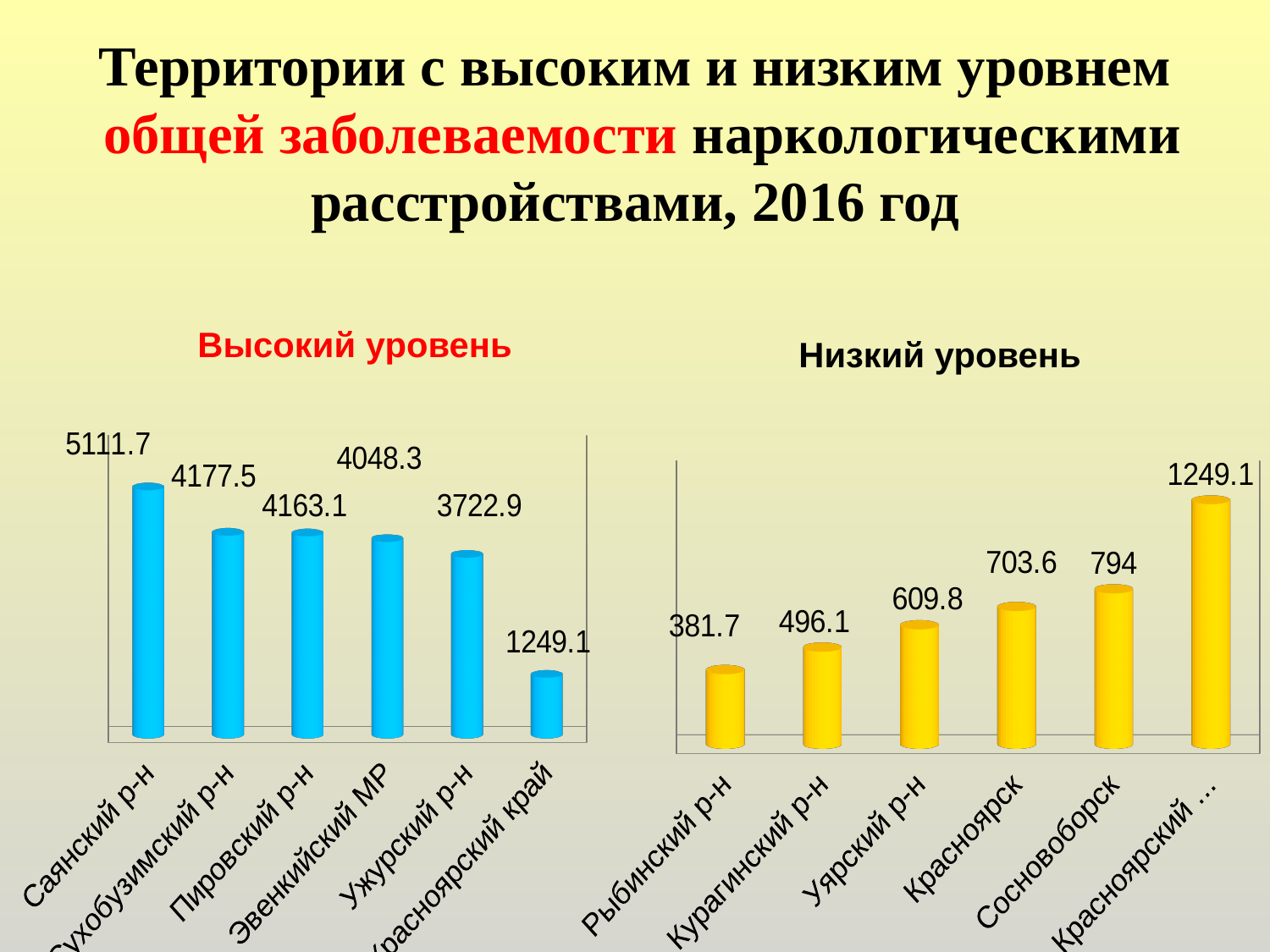
In the 'Низкий уровень' chart, what is the difference between Красноярск and Курагинский р-н? 207.5 In the 'Низкий уровень' chart, which is larger: Уярский р-н or Красноярск? Красноярск In the 'Высокий уровень' chart, which category has the lowest value? Красноярский край In the 'Высокий уровень' chart, how many bars are plotted? 6 In the 'Высокий уровень' chart, what is the difference between Саянский р-н and Ужурский р-н? 1388.8 In the 'Низкий уровень' chart, what is the value for Рыбинский р-н? 381.7 In the 'Высокий уровень' chart, what is the value for Эвенкийский МР? 4048.3 In the 'Низкий уровень' chart, which category has the lowest value? Рыбинский р-н In the 'Низкий уровень' chart, what is the value for Сосновоборск? 794 In the 'Низкий уровень' chart, do the values rise or fall from left to right? rise In the 'Высокий уровень' chart, what is the value for Саянский р-н? 5111.7 What type of chart is the 'Высокий уровень' chart? bar chart